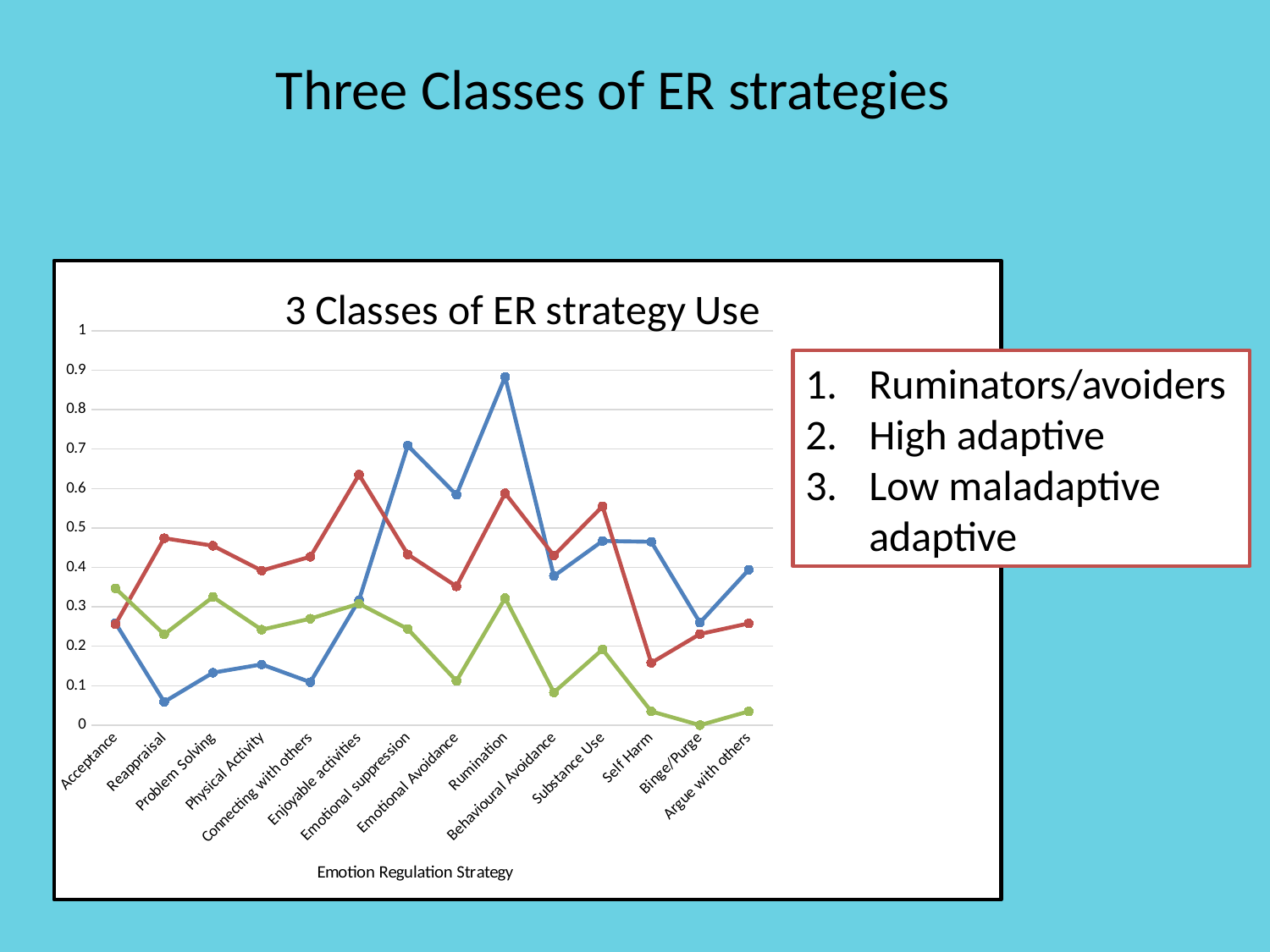
What is the title of the chart? 3 Classes of ER strategy Use For which strategy does the blue line reach its lowest value? Reappraisal Is the value of the blue line for Rumination greater or less than 0.8? greater For Reappraisal, which line has the higher value, the red line or the green line? red line For which strategy does the blue line reach its highest value? Rumination For which strategy does the red line reach its highest value? Enjoyable activities For which strategy does the green line reach its lowest value? Binge/Purge For Emotional suppression, which line has the higher value, the blue line or the red line? blue line Is the value of the red line for Enjoyable activities greater or less than 0.6? greater What kind of chart is shown on the slide? line chart How many emotion regulation strategies are listed along the x axis of the chart? 14 Is the value of the blue line for Reappraisal greater or less than 0.1? less